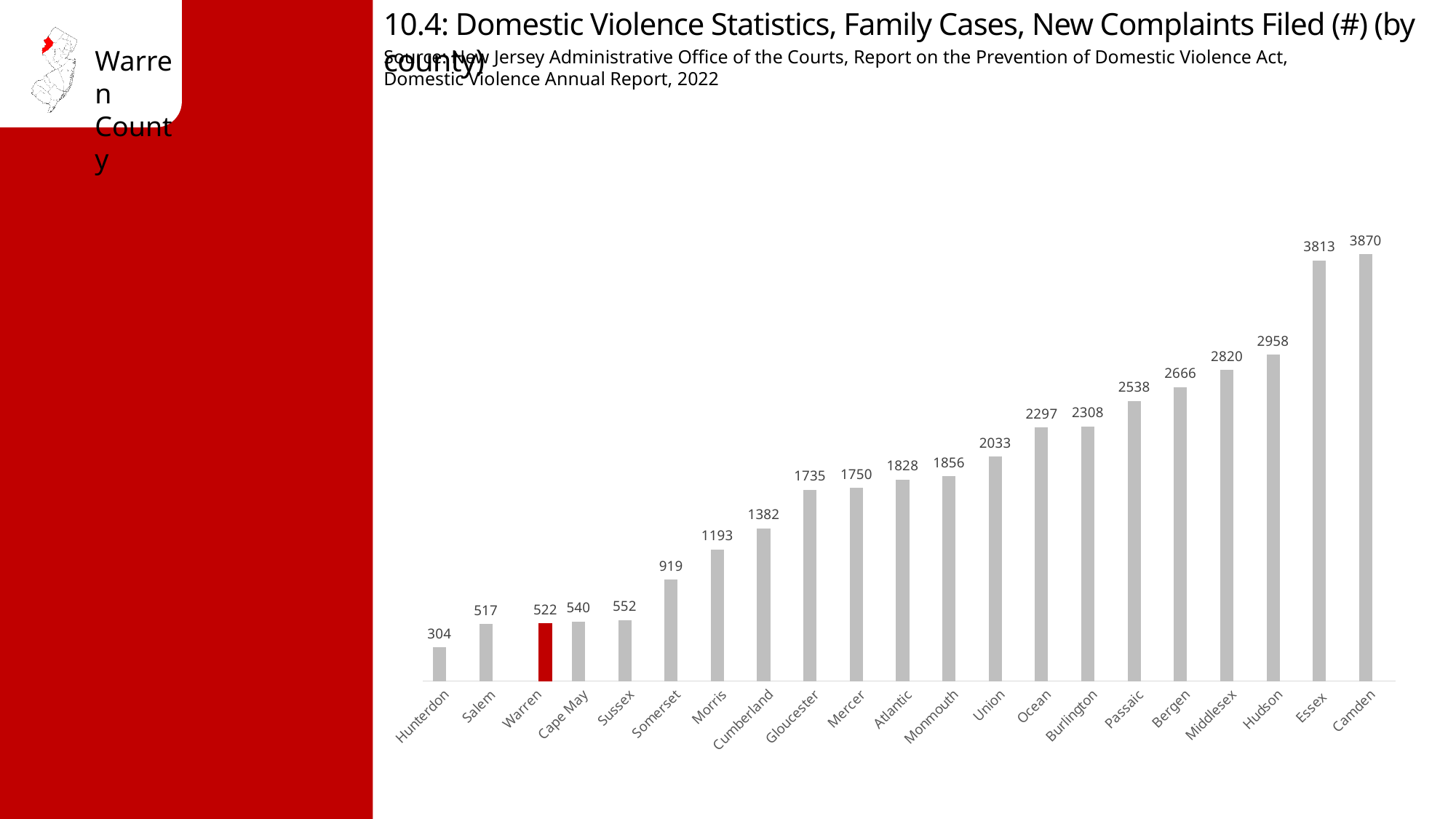
Which has a larger value, Somerset or Cumberland? Cumberland What kind of chart is shown on the slide? Bar chart Which county has the highest number of new complaints filed? Camden Do the values rise or fall moving from left to right along the x axis? Rise What is the value shown for Morris? 1193 What is the value shown for Camden? 3870 Which county's bar is highlighted in red? Warren What is the difference between the values for Warren and Hunterdon? 218 What is the difference between the values for Essex and Hudson? 855 Which county has the lowest number of new complaints filed? Hunterdon How many counties are shown on the chart? 21 What is the number of new domestic violence complaints filed for Warren County? 522